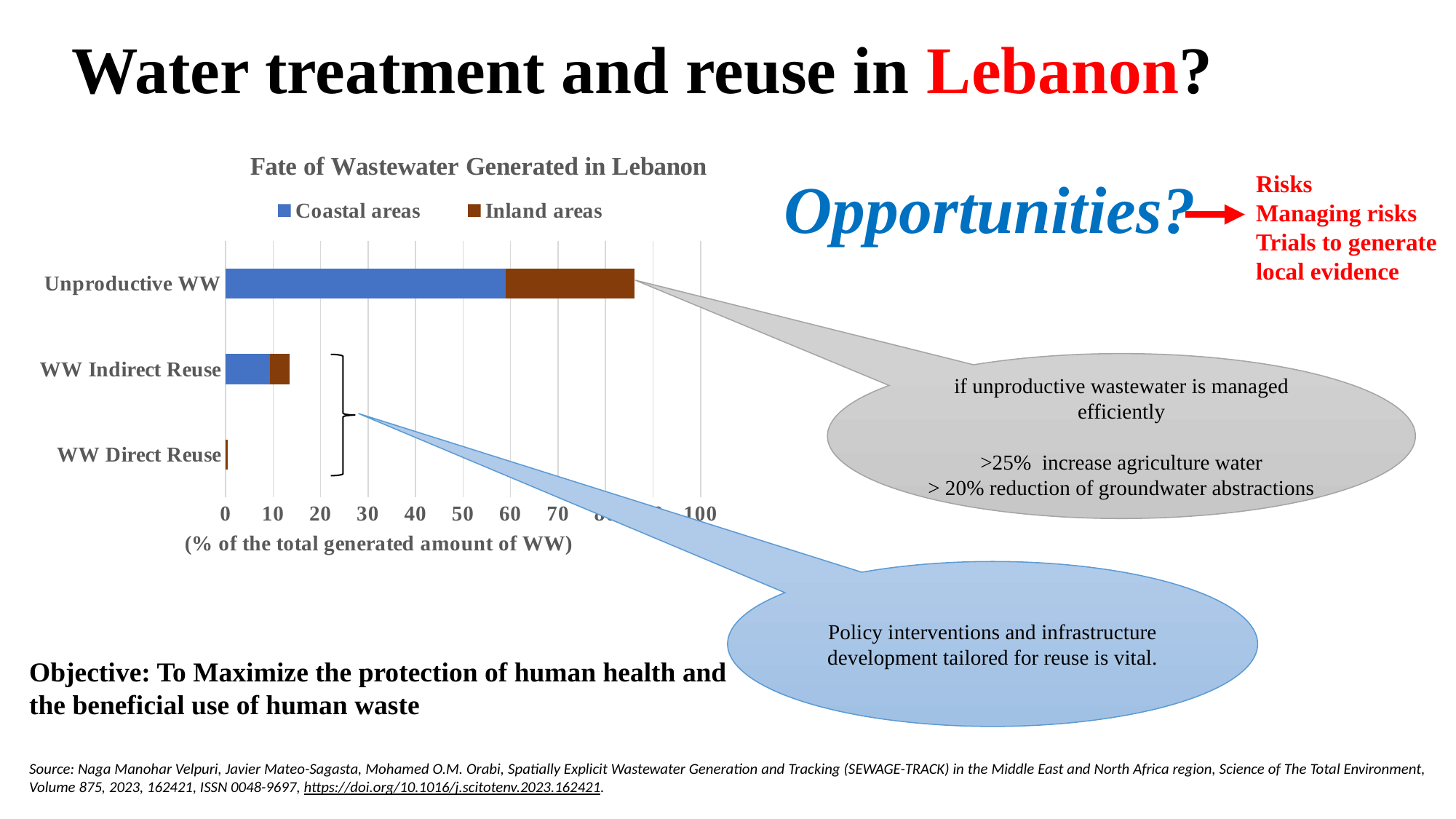
What kind of chart is shown on the slide? bar chart Is the Coastal areas value for Unproductive WW greater or less than 50? greater For Unproductive WW, which is larger: the Coastal areas value or the Inland areas value? Coastal areas Which series is shown in blue in the chart? Coastal areas How many series does the chart legend list? 2 How many categories are plotted on the chart? 3 Which category has the largest total bar in the chart? Unproductive WW Is the total bar for Unproductive WW greater or less than 80? greater Which category has the smallest total bar in the chart? WW Direct Reuse What is the title of the chart? Fate of Wastewater Generated in Lebanon Which is larger: the total bar for WW Indirect Reuse or the total bar for WW Direct Reuse? WW Indirect Reuse Is the total bar for WW Indirect Reuse greater or less than 20? less